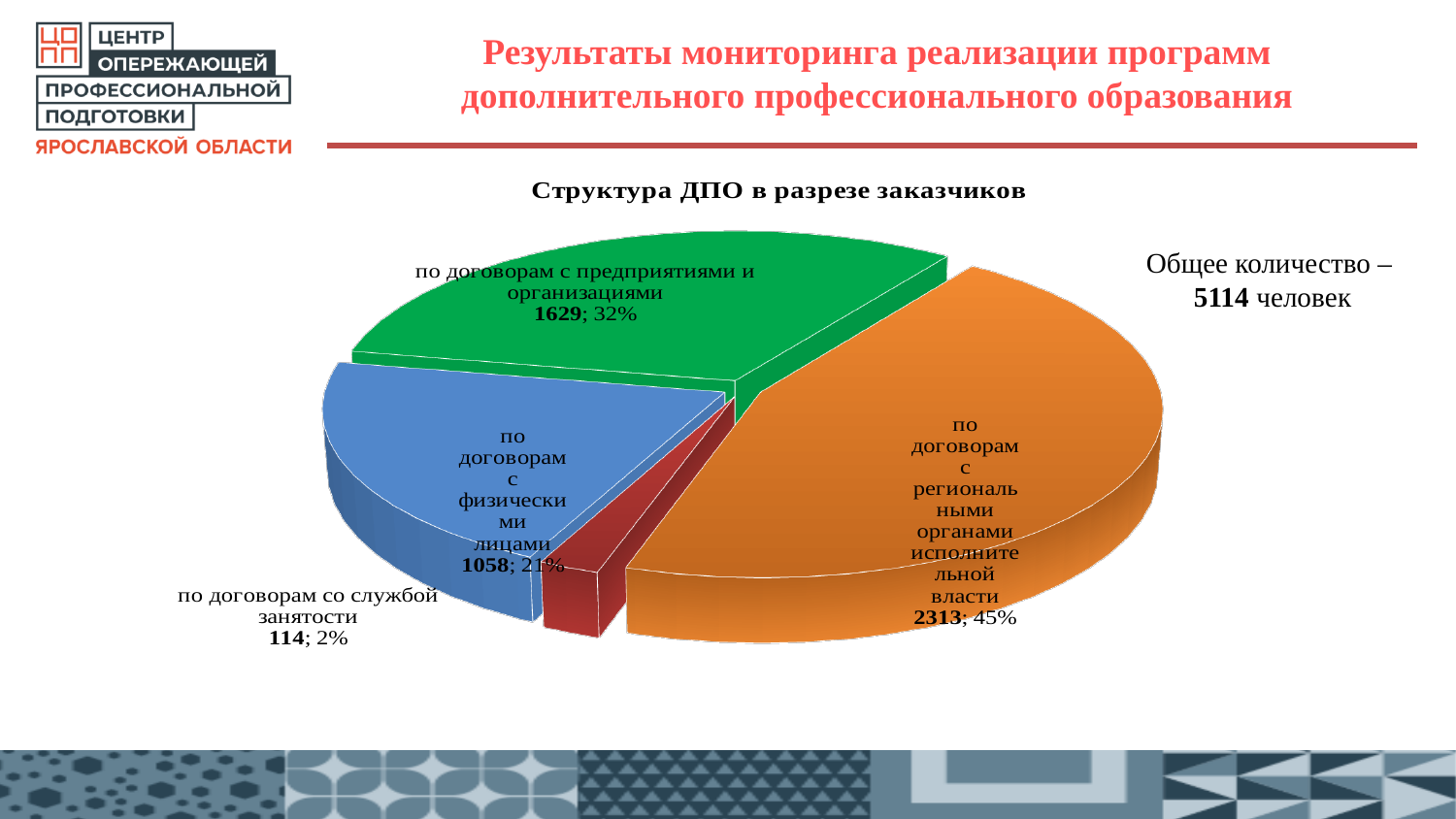
What is the value for 'по договорам со службой занятости'? 114 What is the value for 'по договорам с предприятиями и организациями'? 1629 What kind of chart is shown on the slide? pie chart What is the title of the chart? Структура ДПО в разрезе заказчиков What is the value for 'по договорам с физическими лицами'? 1058 How many slices does the pie chart have? 4 Which category has the largest share of the pie? по договорам с региональными органами исполнительной власти What is the difference between the values for 'по договорам с региональными органами исполнительной власти' and 'по договорам с физическими лицами'? 1255 What share of the pie does 'по договорам с предприятиями и организациями' represent? 32% Which category has the smallest share of the pie? по договорам со службой занятости Which is larger: the value for 'по договорам с предприятиями и организациями' or for 'по договорам с физическими лицами'? по договорам с предприятиями и организациями What is the value for 'по договорам с региональными органами исполнительной власти'? 2313